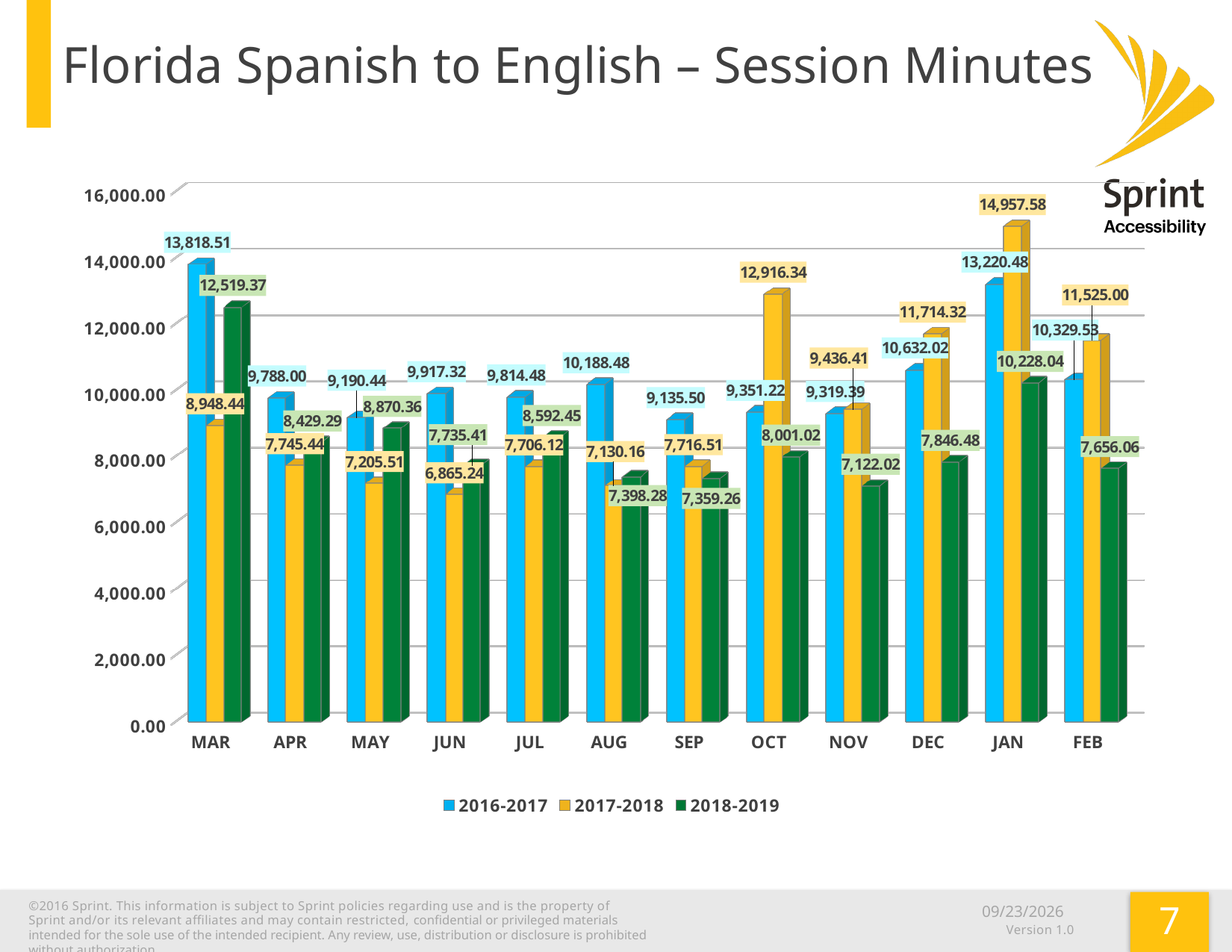
Which month has the highest 2017-2018 value? JAN How many series does the legend list? 3 How many months are shown on the x axis? 12 Which month has the lowest 2017-2018 value? JUN What is the 2016-2017 value for MAR? 13,818.51 What kind of chart is shown on the slide? bar chart Which month has the lowest 2018-2019 value? NOV Is the 2016-2017 value for AUG greater or less than 10,000.00? greater What is the 2018-2019 value for JUL? 8,592.45 In DEC, which series has the larger value, 2016-2017 or 2017-2018? 2017-2018 What is the 2017-2018 value for OCT? 12,916.34 What is the difference between the 2016-2017 and 2018-2019 values for MAR? 1,299.14